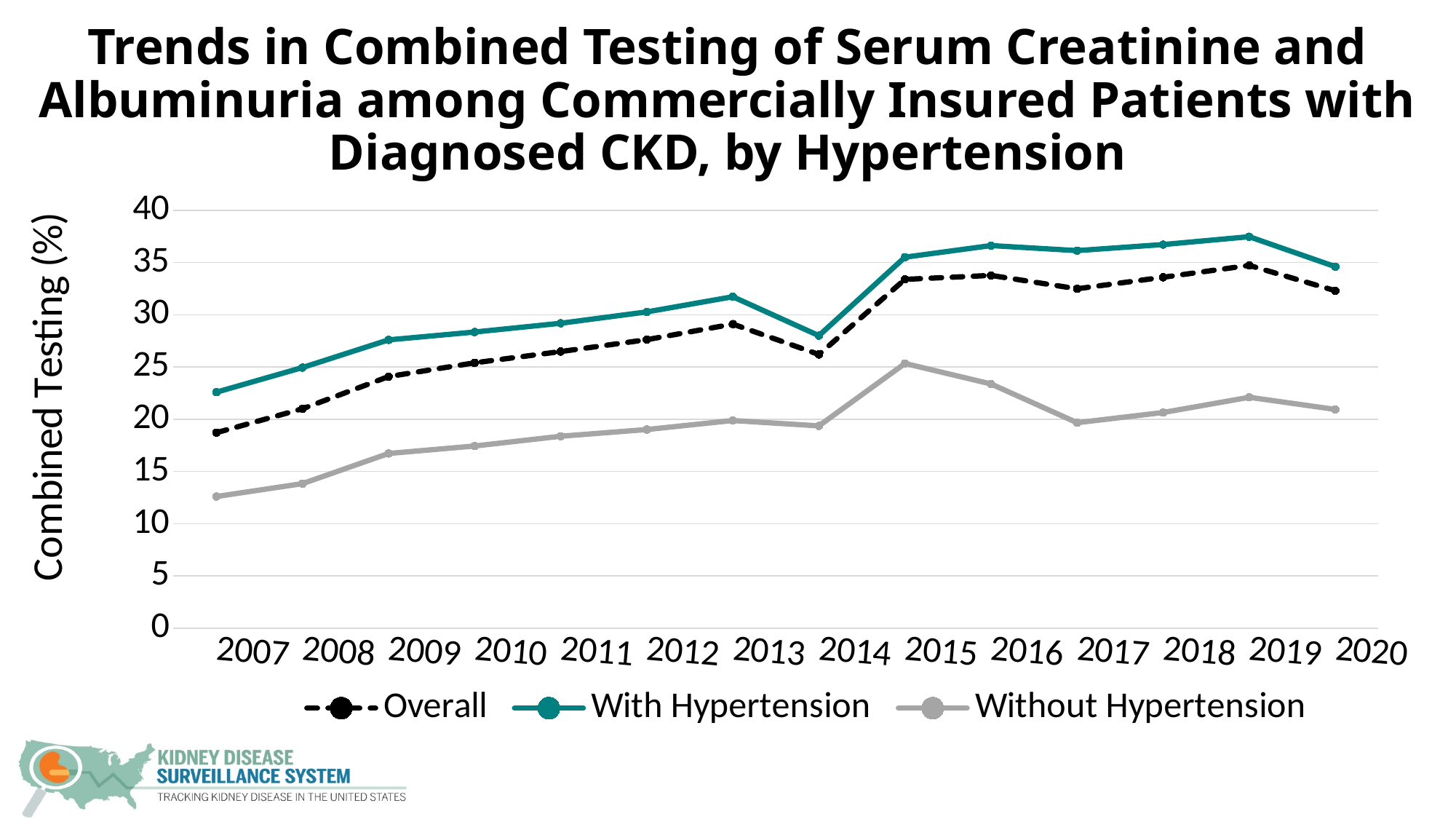
Is the value for Overall in 2014 greater or less than 30? less In which year is the Without Hypertension series at its highest? 2015 What kind of chart is shown on the slide? line chart Is the value for With Hypertension in 2007 greater or less than 20? greater Is the value for Without Hypertension in 2007 greater or less than 15? less In which year is the Without Hypertension series at its lowest? 2007 What is the label on the y axis? Combined Testing (%) Does the Without Hypertension series rise or fall from 2007 to 2013? rise For With Hypertension, which year has the higher value, 2013 or 2014? 2013 How many years are plotted along the x axis? 14 How many series does the legend list? 3